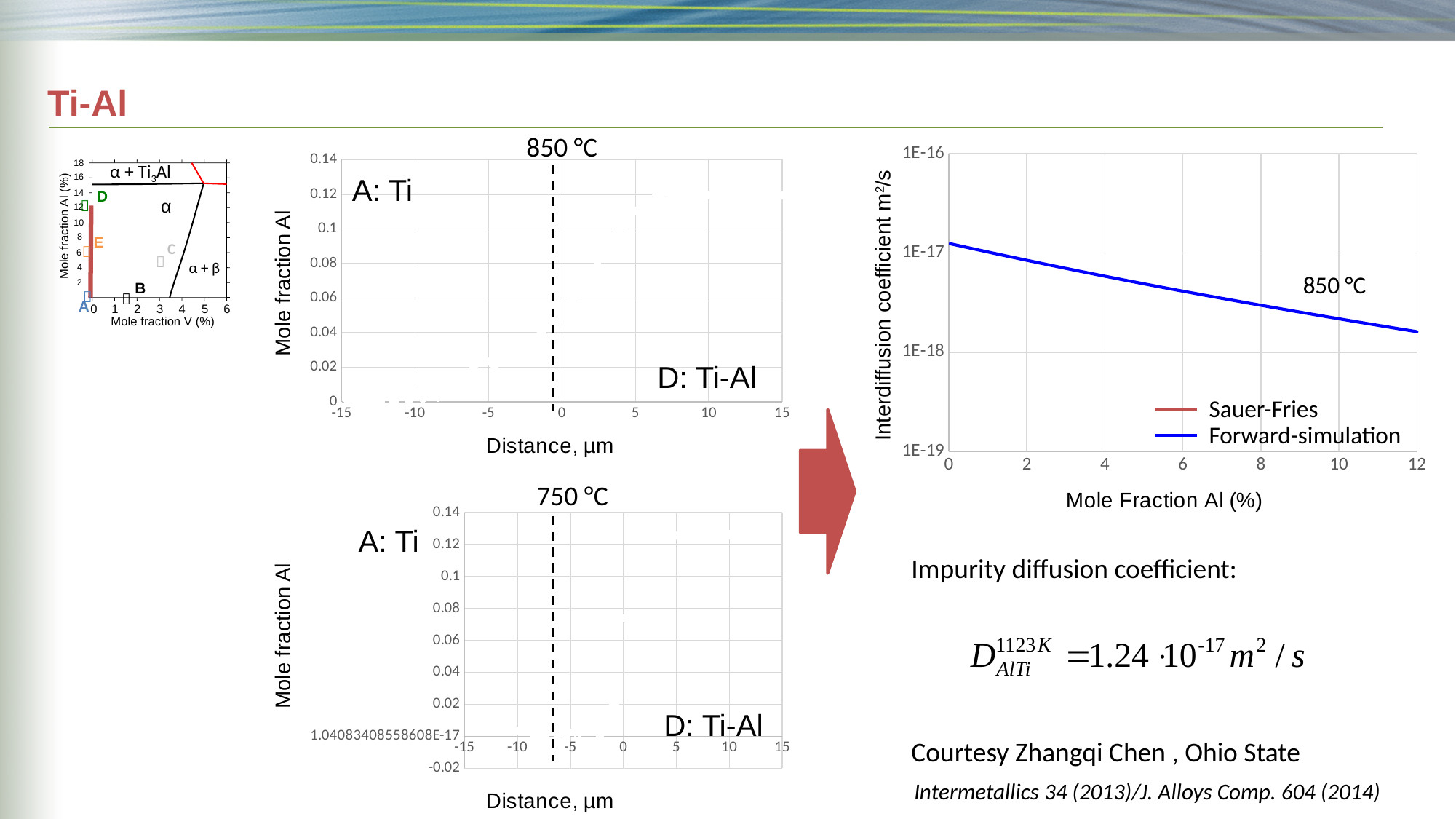
On the right-hand chart of interdiffusion coefficient versus Mole Fraction Al (%), is the Forward-simulation value at 12% Al greater or less than 1E-18? greater On the right-hand chart of interdiffusion coefficient versus Mole Fraction Al (%), what colour is the Forward-simulation line in the legend? blue On the right-hand chart of interdiffusion coefficient versus Mole Fraction Al (%), how many series does the legend list? 2 How many charts on the slide are titled with a temperature (850 °C or 750 °C) and plot Mole fraction Al against Distance, µm? 2 On the small phase diagram at the top left, what is the highest value labelled on the Mole fraction V (%) axis? 6 What kind of chart is the right-hand chart of interdiffusion coefficient versus Mole Fraction Al (%)? line chart On the right-hand chart of interdiffusion coefficient versus Mole Fraction Al (%), is the Forward-simulation value at 6% Al greater or less than 1E-17? less On the right-hand chart of interdiffusion coefficient versus Mole Fraction Al (%), what is the lowest value labelled on the y axis? 1E-19 On the right-hand chart of interdiffusion coefficient versus Mole Fraction Al (%), what is the highest value shown on the x axis? 12 On the right-hand chart of interdiffusion coefficient versus Mole Fraction Al (%), what temperature is annotated next to the line? 850 °C On the small phase diagram at the top left, what is the highest value labelled on the Mole fraction Al (%) axis? 18 On the right-hand chart of interdiffusion coefficient versus Mole Fraction Al (%), does the Forward-simulation line rise or fall as Mole Fraction Al increases? fall